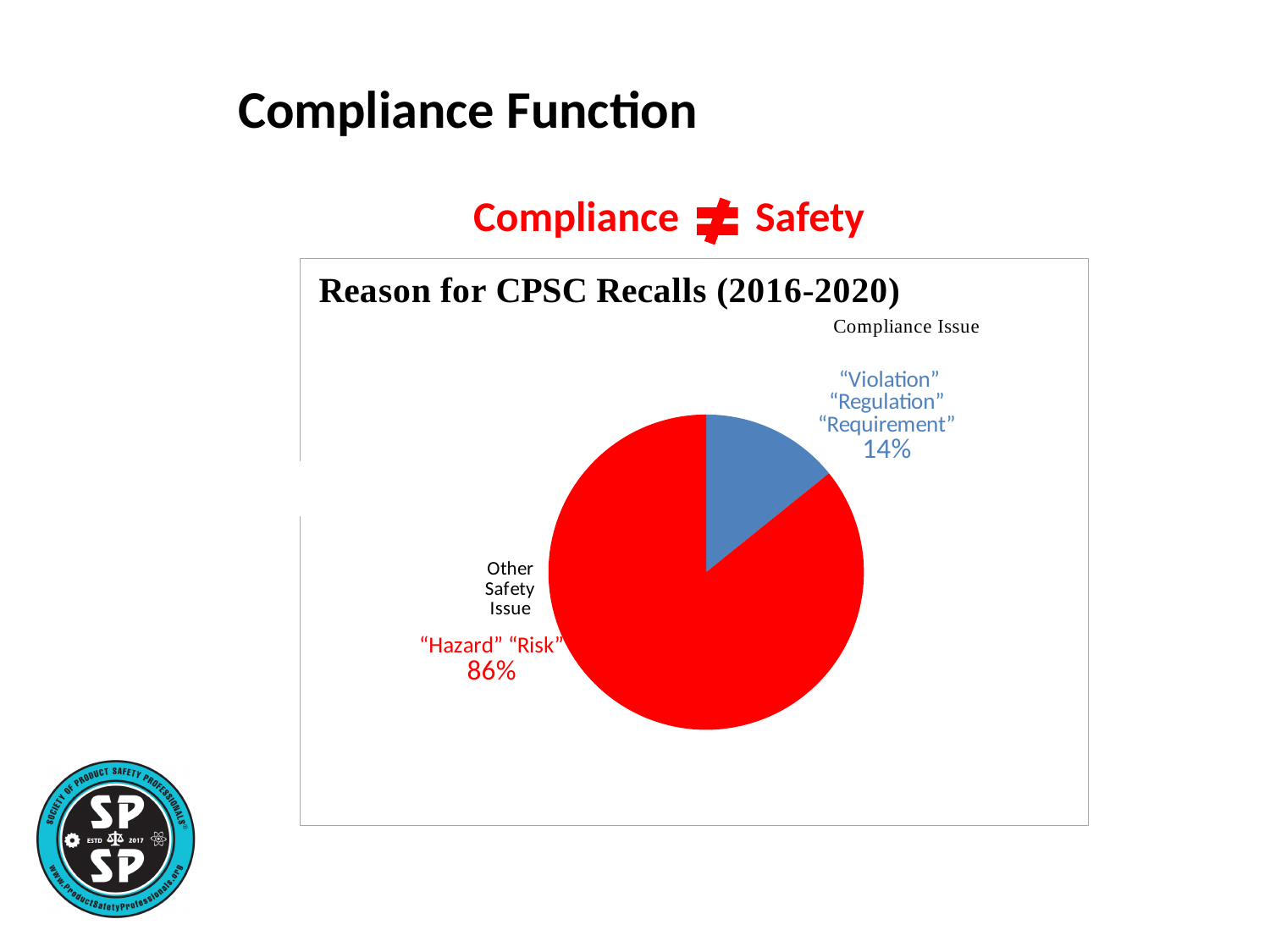
What share of the pie does the Compliance Issue slice represent? 14% Which is larger, the Compliance Issue slice or the Other Safety Issue slice? Other Safety Issue How many slices does the pie chart have? 2 Which slice of the pie is the largest? Other Safety Issue What colour is the Other Safety Issue slice? red What percentage of CPSC recalls were due to Other Safety Issue? 86% What is the title of the chart? Reason for CPSC Recalls (2016-2020) What is the difference in percentage points between the Other Safety Issue slice and the Compliance Issue slice? 72 Which slice of the pie is the smallest? Compliance Issue What kind of chart is shown on the slide? pie chart What percentage of CPSC recalls were due to a Compliance Issue? 14%